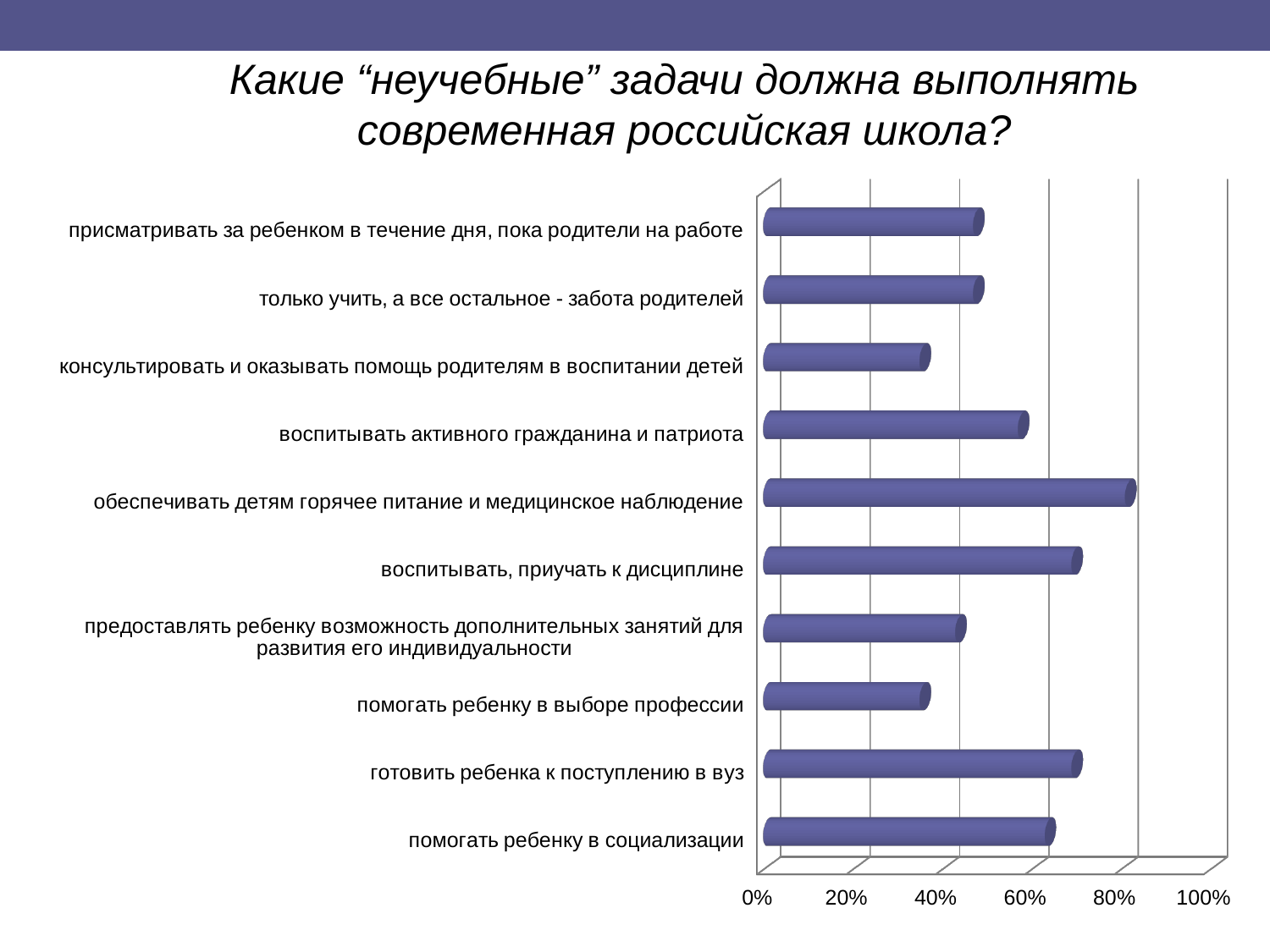
Which is larger: the value for "обеспечивать детям горячее питание и медицинское наблюдение" or for "помогать ребенку в социализации"? обеспечивать детям горячее питание и медицинское наблюдение Is the value for "помогать ребенку в выборе профессии" greater or less than 60%? less What kind of chart is shown on the slide? bar chart Which task has the highest value in the chart? обеспечивать детям горячее питание и медицинское наблюдение How many categories (tasks) are plotted in the chart? 10 Is the value for "помогать ребенку в социализации" greater or less than 40%? greater Is the value for "консультировать и оказывать помощь родителям в воспитании детей" greater or less than 60%? less Which is larger: the value for "готовить ребенка к поступлению в вуз" or for "помогать ребенку в выборе профессии"? готовить ребенка к поступлению в вуз What is the title of the slide containing the chart? Какие “неучебные” задачи должна выполнять современная российская школа? Which is larger: the value for "воспитывать активного гражданина и патриота" or for "консультировать и оказывать помощь родителям в воспитании детей"? воспитывать активного гражданина и патриота